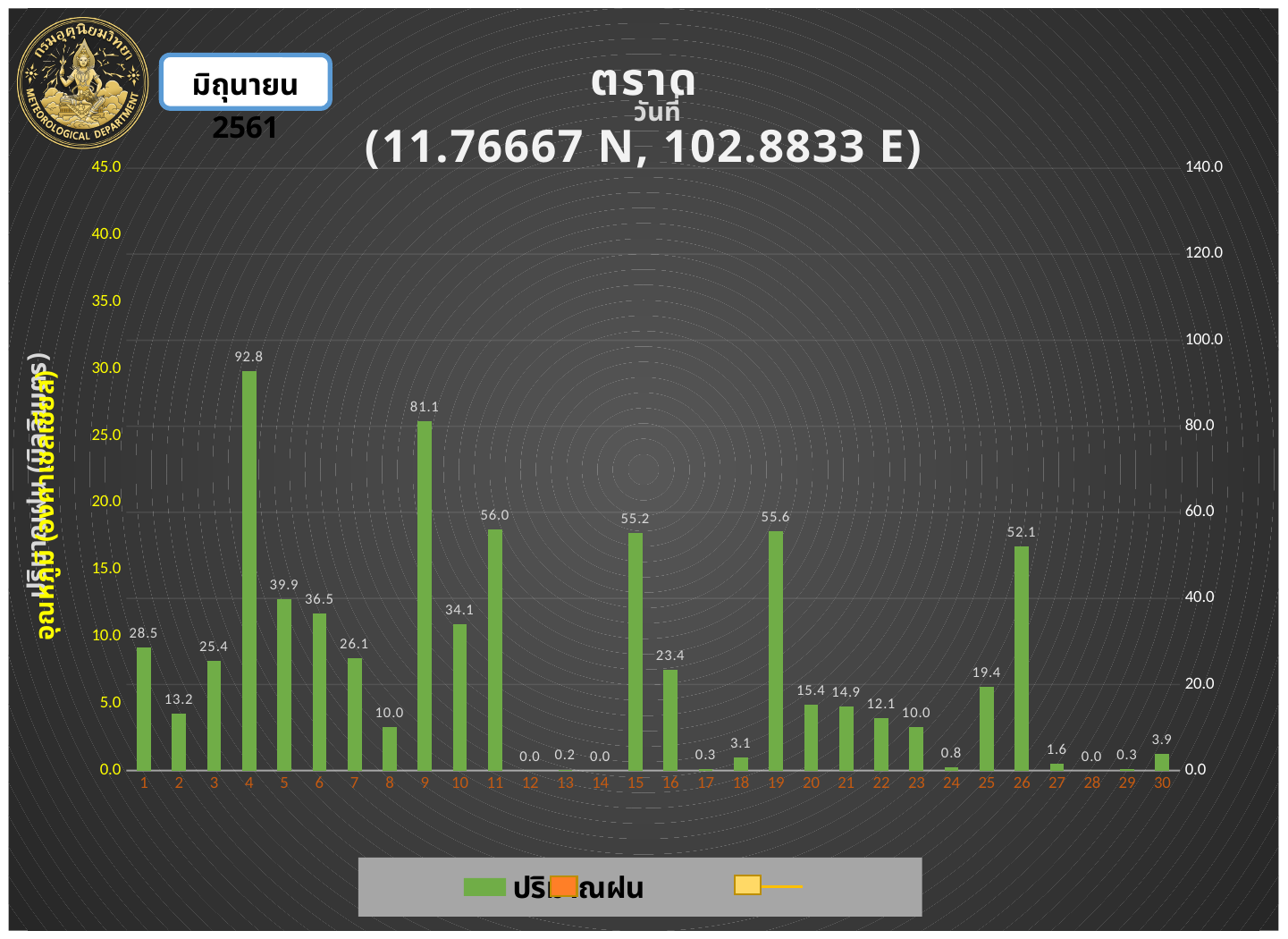
What is the rainfall value for day 19? 55.6 What is the difference between the rainfall values for day 4 and day 9? 11.7 What is the lowest rainfall value shown on the chart? 0.0 What kind of chart is shown on the slide? bar chart Which day has the larger rainfall value, day 5 or day 6? 5 What coordinates are given in the chart title? 11.76667 N, 102.8833 E What is the rainfall value for day 4? 92.8 What is the rainfall value for day 26? 52.1 What is the rainfall value for day 9? 81.1 How many days are shown on the x axis of the chart? 30 Is the rainfall value for day 26 greater or less than 40.0 on the right axis? greater Which day has the highest rainfall value? 4